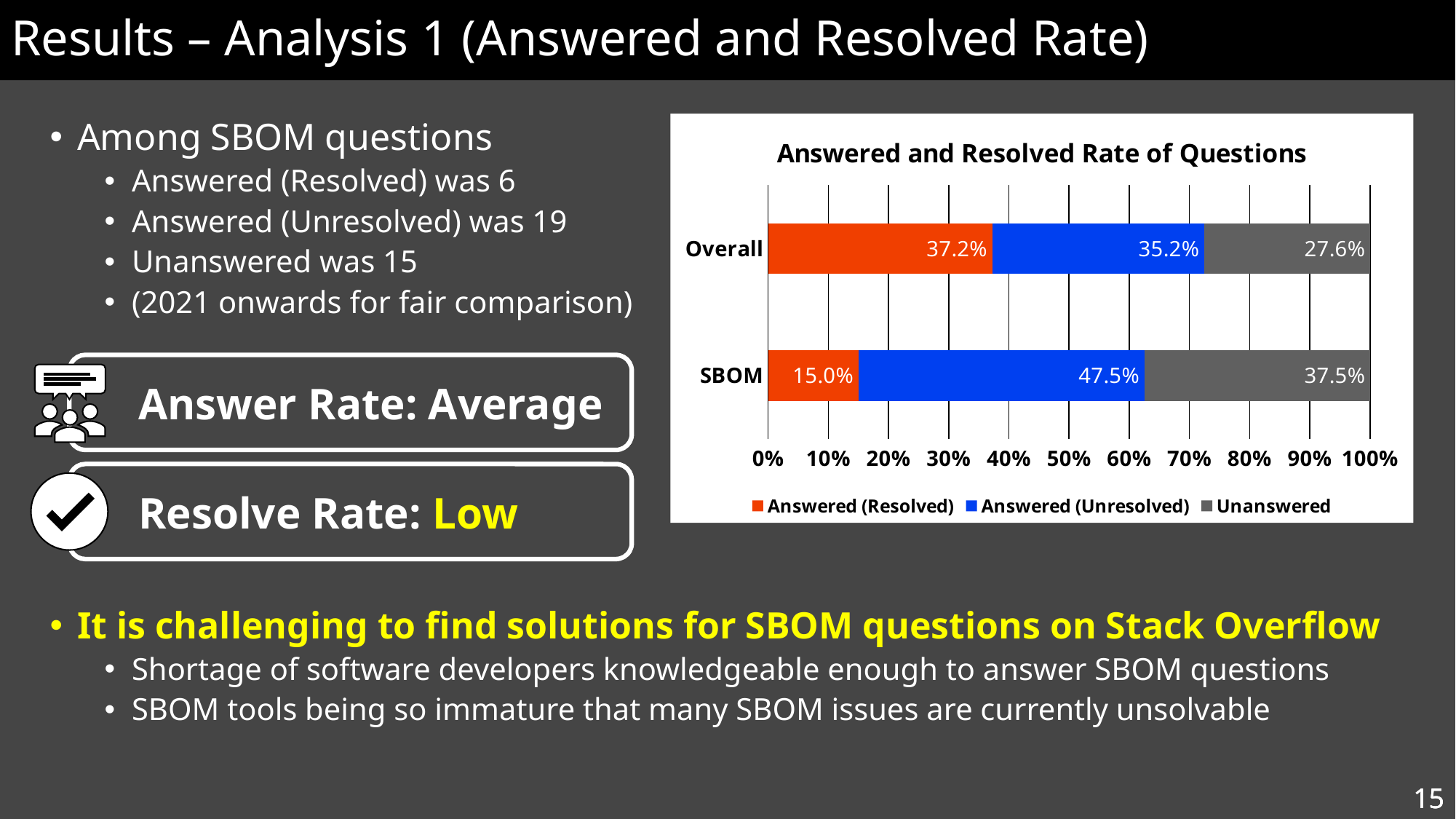
How many series does the legend list? 3 What is the Answered (Unresolved) value for Overall? 35.2% Which category has the lower Answered (Resolved) value? SBOM What is the title of the chart? Answered and Resolved Rate of Questions What is the difference between the Answered (Resolved) values for Overall and SBOM? 22.2% What is the Answered (Resolved) value for Overall? 37.2% What kind of chart is shown on the slide? Stacked bar chart What is the difference between the Unanswered values for SBOM and Overall? 9.9% Which category has the higher Answered (Unresolved) value, Overall or SBOM? SBOM What is the Unanswered value for SBOM? 37.5% What is the Answered (Resolved) value for SBOM? 15.0% How many categories are shown on the chart? 2